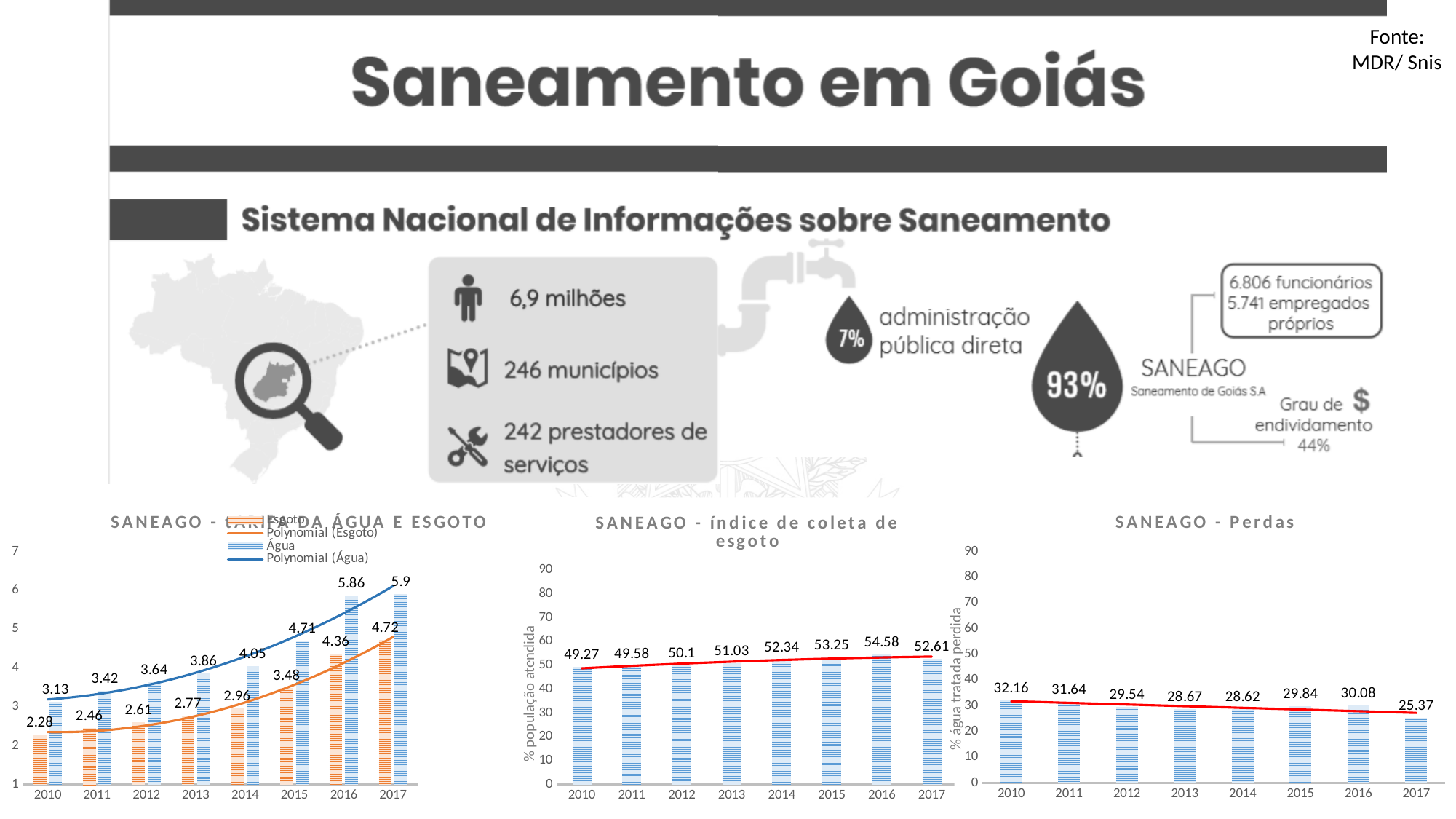
In the left chart, what is the Esgoto value for 2013? 2.77 In the chart 'SANEAGO - Perdas', which year has the highest value? 2010 In the chart 'SANEAGO - índice de coleta de esgoto', what is the value for 2016? 54.58 How many series does the legend of the left chart list? 4 In the left chart, which year has the highest Esgoto value? 2017 What type of chart is 'SANEAGO - Perdas'? bar chart In the chart 'SANEAGO - Perdas', is the value for 2011 larger or smaller than the value for 2015? larger In the chart 'SANEAGO - Perdas', what is the value for 2017? 25.37 In the chart 'SANEAGO - índice de coleta de esgoto', which year has the lowest value? 2010 In the left chart, what is the difference between the Água and Esgoto values in 2017? 1.18 In the left chart, what is the Água value for 2016? 5.86 In the chart 'SANEAGO - índice de coleta de esgoto', how many years are shown on the x axis? 8